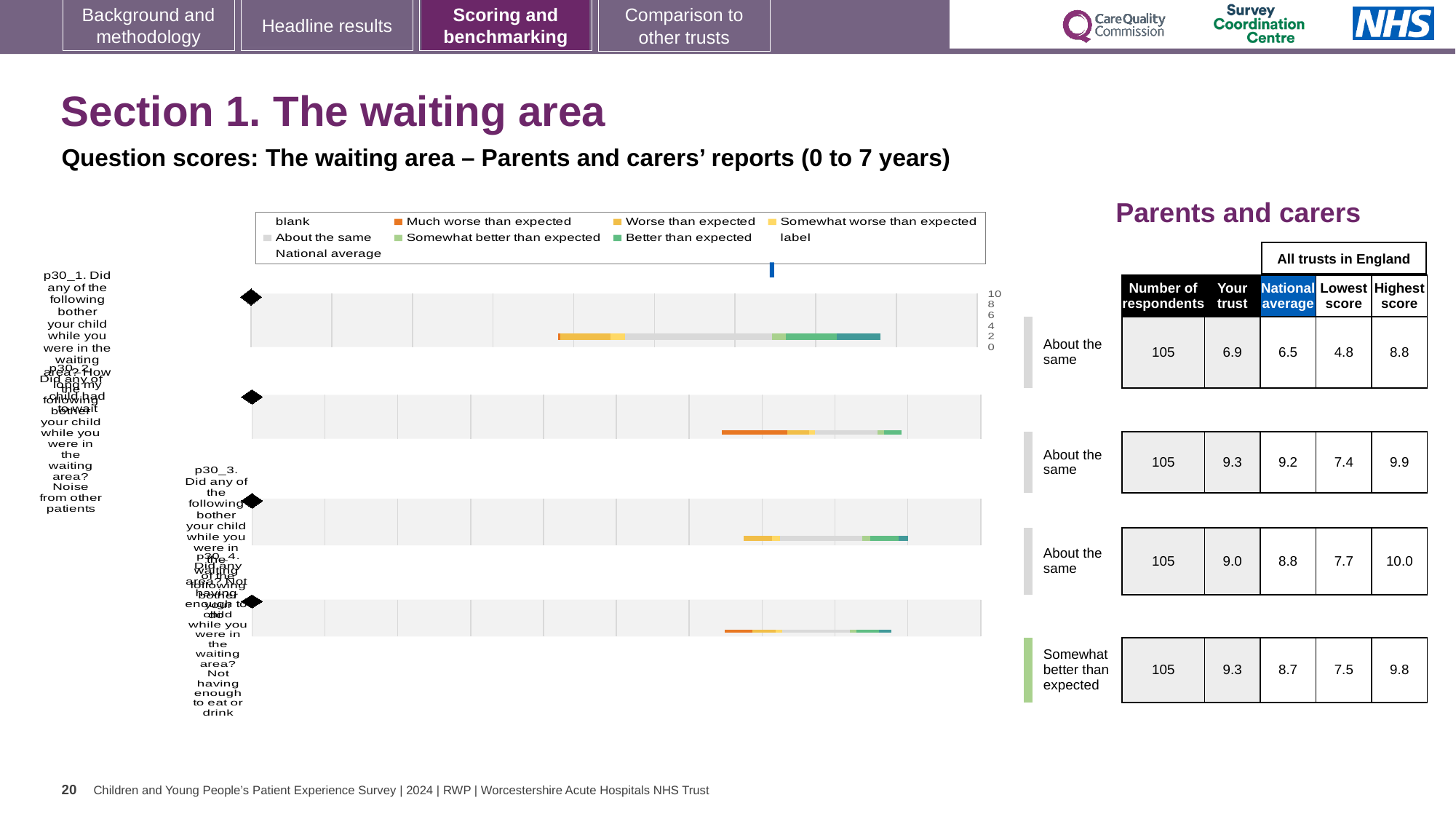
In the table, what is the national average for the third question (p30_3)? 8.8 How many questions (bars) are plotted in the chart? 4 What kind of chart is shown on the slide? bar chart Which question has the lowest 'Your trust' score in the table? p30_1 (6.9) In the table, what is the 'Your trust' score for the first question (p30_1)? 6.9 For the first question (p30_1), which is larger: the 'Your trust' score or the national average? Your trust In the table, what is the highest score across all trusts in England for the third question (p30_3)? 10.0 What is the maximum value shown on the chart's score axis? 10 How many entries does the chart legend list? 9 For the fourth question (p30_4), what is the difference between the 'Your trust' score and the national average? 0.6 In the table, how many respondents are listed for the first question (p30_1)? 105 What colour does the legend use for 'Much worse than expected'? orange